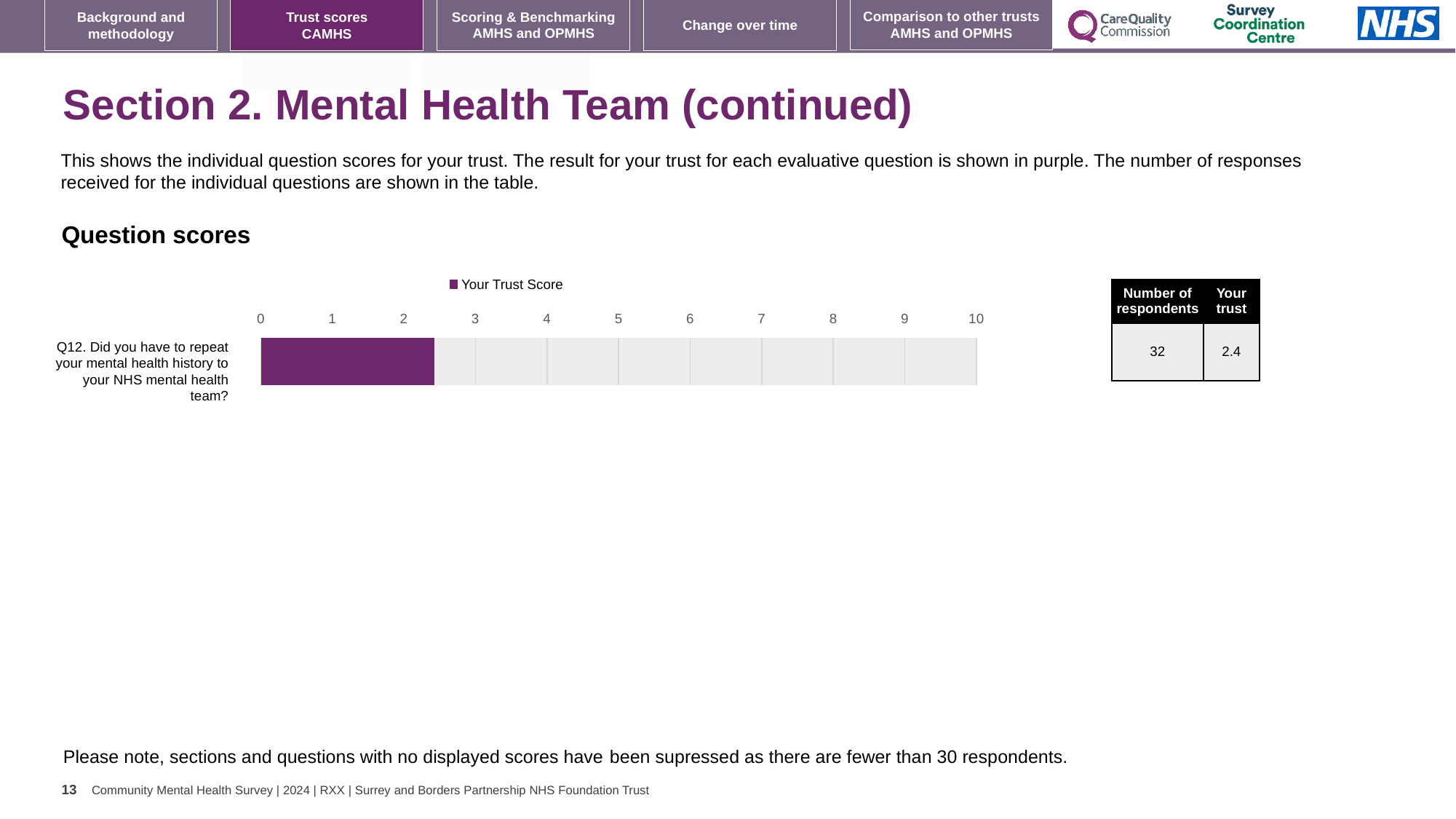
Is the trust score for Q12 greater or less than 3? less How many series does the chart legend list? 1 Is the trust score for Q12 greater or less than 2? greater What kind of chart is shown under 'Question scores'? bar chart What is the name of the series shown in the chart legend? Your Trust Score How many questions (categories) are plotted in the chart? 1 How many respondents answered Q12 according to the table? 32 What is the maximum value shown on the chart's horizontal axis? 10 Is the trust score for Q12 greater or less than 5? less What is the trust score for Q12 (Did you have to repeat your mental health history to your NHS mental health team?) as shown in the table? 2.4